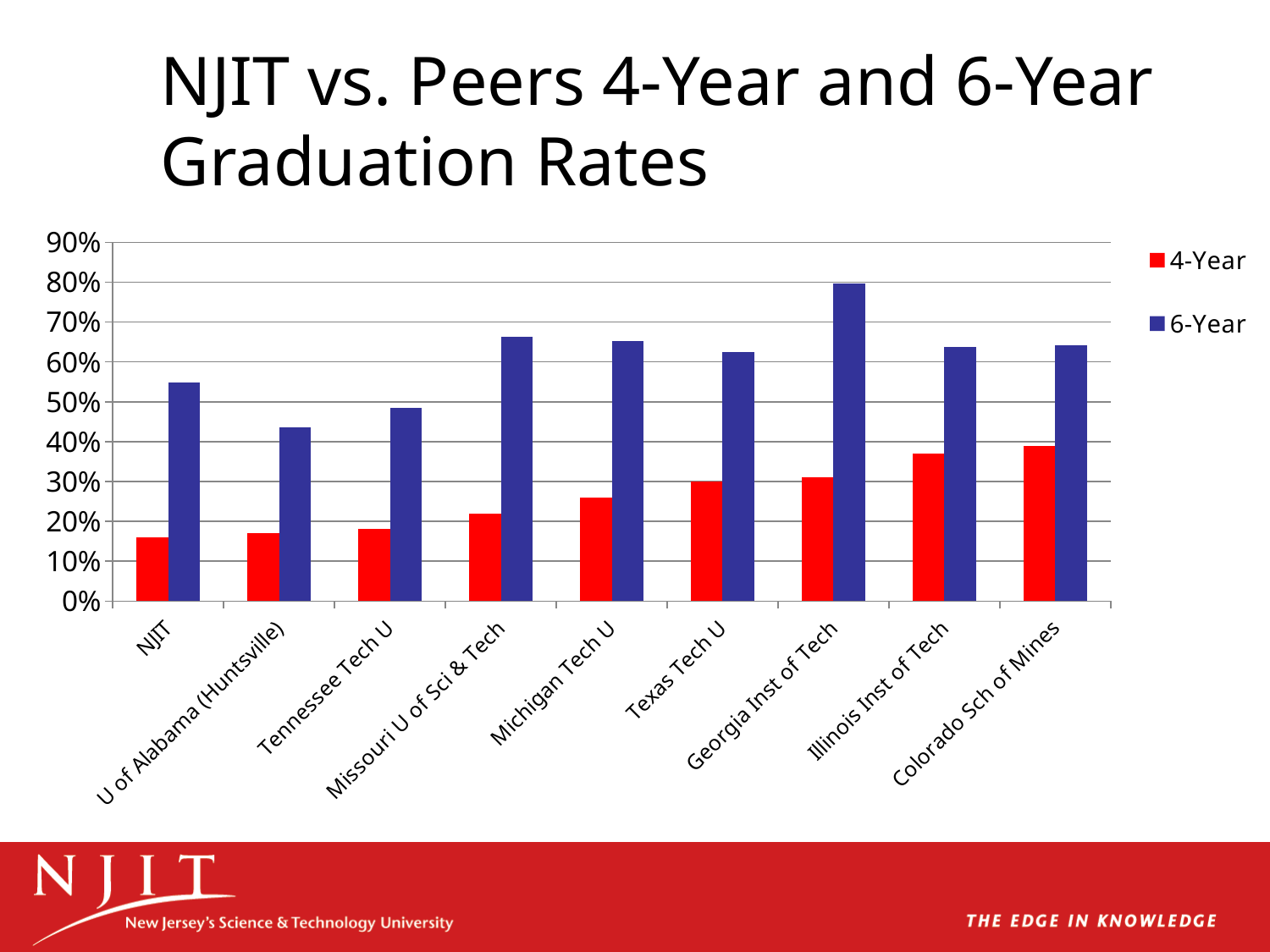
Is the 6-Year graduation rate for Georgia Inst of Tech greater or less than 70%? greater Which institution has the lowest 6-Year graduation rate? U of Alabama (Huntsville) Which is larger, the 4-Year graduation rate for Colorado Sch of Mines or for NJIT? Colorado Sch of Mines Is the 6-Year graduation rate for NJIT greater or less than 50%? greater Is the 4-Year graduation rate for Illinois Inst of Tech greater or less than 30%? greater What kind of chart is shown on the slide? Bar chart How many institutions are shown on the x axis? 9 Which is larger, the 6-Year graduation rate for Missouri U of Sci & Tech or for Tennessee Tech U? Missouri U of Sci & Tech Which institution has the highest 6-Year graduation rate? Georgia Inst of Tech How many series does the legend list? 2 What colour are the bars for the 6-Year series? Blue